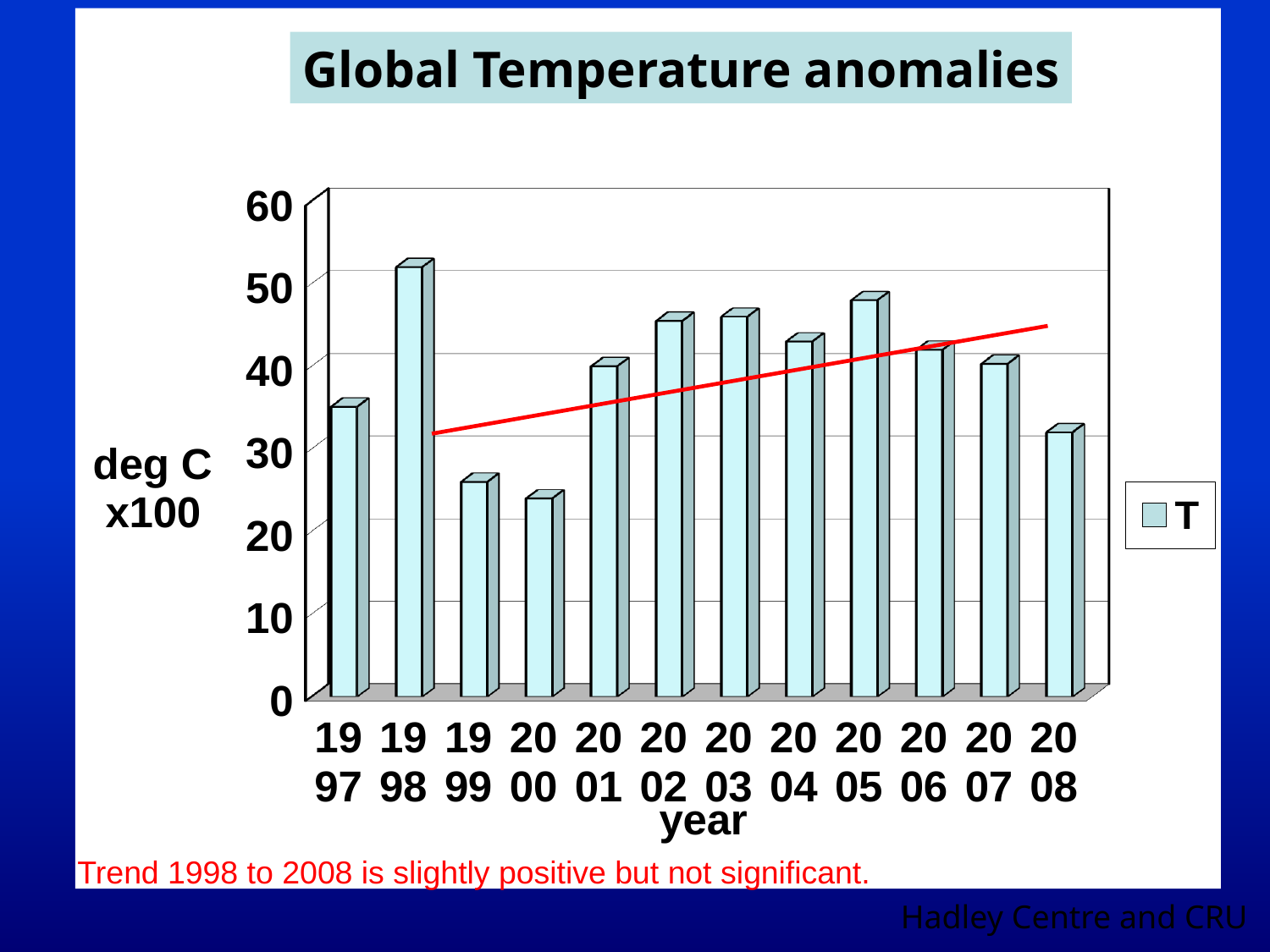
What is the label on the vertical axis of the chart? deg C x100 What kind of chart is shown on the slide? bar chart Is the value for 2000 greater or less than 30? less Which is larger, the value for 2000 or the value for 2001? 2001 Is the value for 2008 greater or less than 40? less How many years are plotted on the x axis of the chart? 12 What is the title of the chart? Global Temperature anomalies Which is larger, the value for 1997 or the value for 1998? 1998 How many series does the chart's legend list? 1 Is the value for 1998 greater or less than 40? greater Which year has the highest bar in the chart? 1998